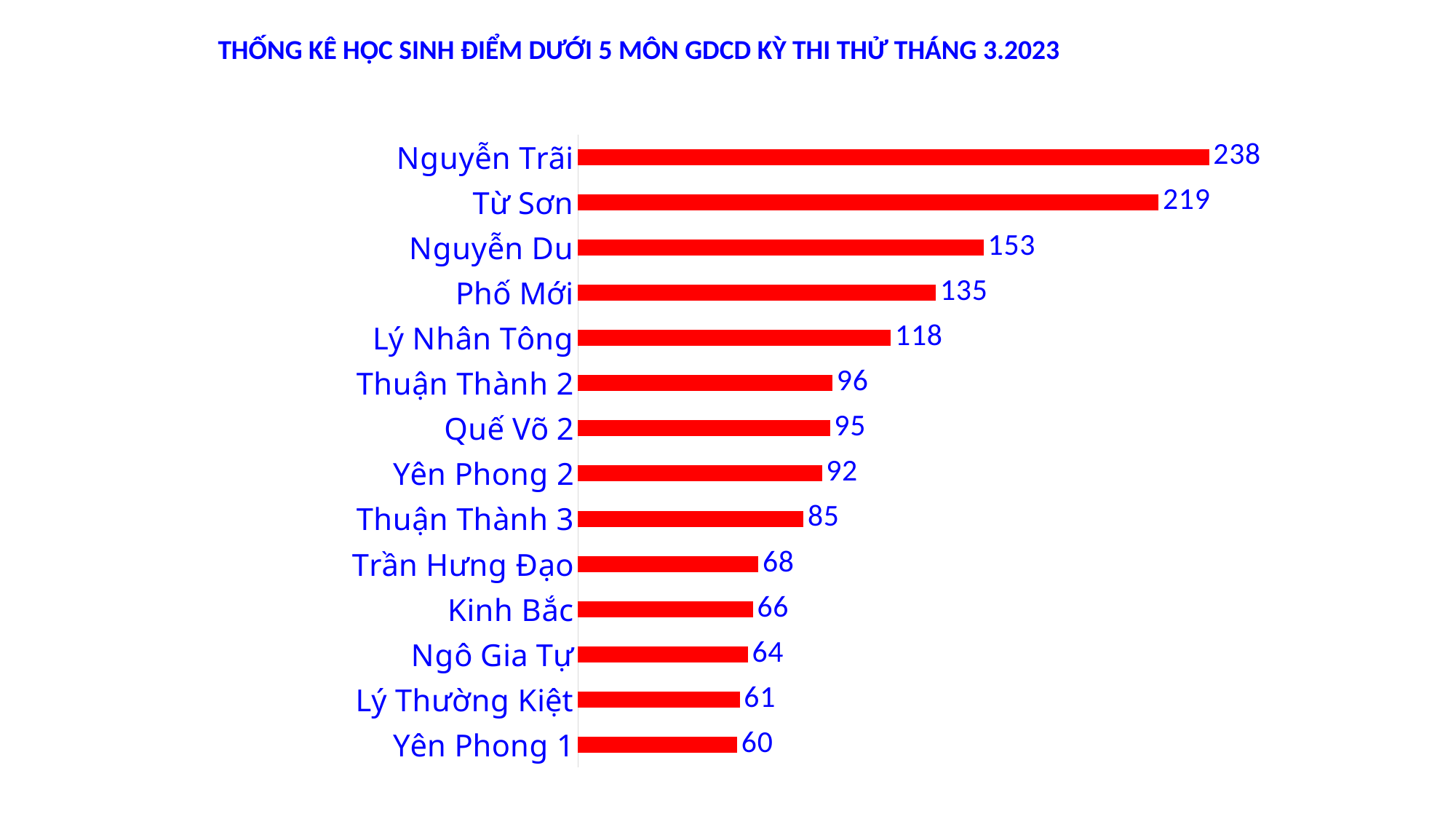
Which school has the lowest value? Yên Phong 1 What colour are the bars in the chart? Red What is the difference between the values for Nguyễn Trãi and Từ Sơn? 19 What is the value for Thuận Thành 3? 85 What is the difference between the values for Nguyễn Du and Lý Nhân Tông? 35 Which is larger, the value for Từ Sơn or the value for Nguyễn Du? Từ Sơn How many schools are shown in the chart? 14 What kind of chart is shown on the slide? Bar chart What is the value for Phố Mới? 135 What is the value for Nguyễn Trãi? 238 Which is larger, the value for Trần Hưng Đạo or the value for Thuận Thành 2? Thuận Thành 2 Which school has the highest value? Nguyễn Trãi